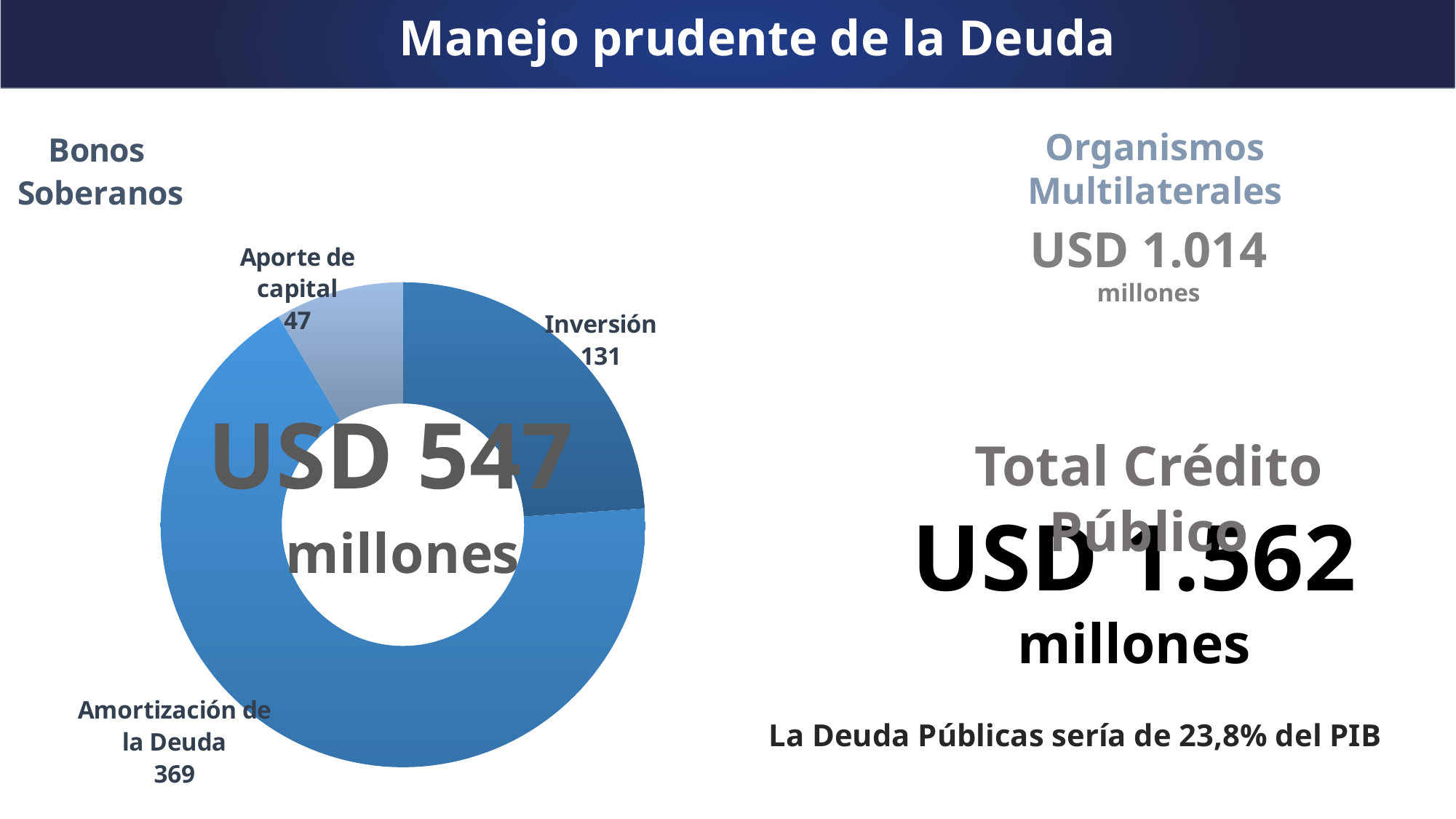
Which category has the largest slice in the Bonos Soberanos chart? Amortización de la Deuda What is the value for Aporte de capital in the Bonos Soberanos chart? 47 How many slices does the Bonos Soberanos chart have? 3 What is the difference between Inversión and Aporte de capital in the Bonos Soberanos chart? 84 What total is shown in the centre of the Bonos Soberanos chart? USD 547 millones What is the value for Inversión in the Bonos Soberanos chart? 131 What is the value for Amortización de la Deuda in the Bonos Soberanos chart? 369 Which is larger in the Bonos Soberanos chart, Inversión or Aporte de capital? Inversión Which category has the smallest slice in the Bonos Soberanos chart? Aporte de capital What is the difference between Amortización de la Deuda and Inversión in the Bonos Soberanos chart? 238 What share of the Bonos Soberanos total of 547 does Amortización de la Deuda (369) represent? 67.5% What kind of chart is the Bonos Soberanos chart? pie (donut) chart